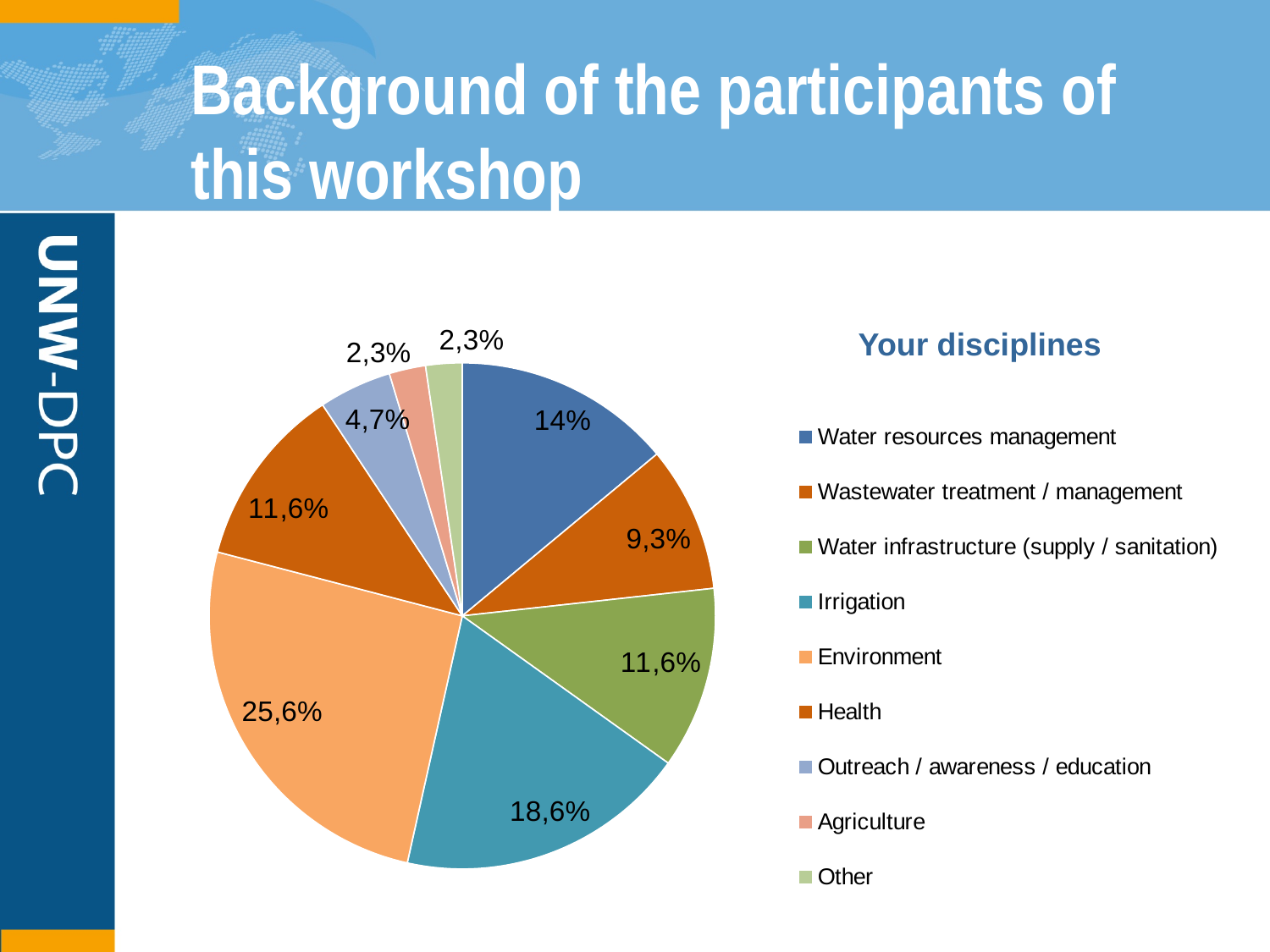
What is the difference between the Water resources management share and the Wastewater treatment / management share? 4,7% Which is larger, the Irrigation slice or the Water resources management slice? Irrigation What percentage of the pie is Irrigation? 18,6% What percentage is shown for Outreach / awareness / education? 4,7% What is the title of the chart? Your disciplines How many slices does the pie chart have? 9 Which discipline has the largest slice of the pie? Environment What share does Wastewater treatment / management have? 9,3% What is the difference between the Environment share and the Irrigation share? 7% What type of chart is shown on the slide? Pie chart What share of participants have a background in Environment? 25,6% What is the value shown for Water resources management? 14%